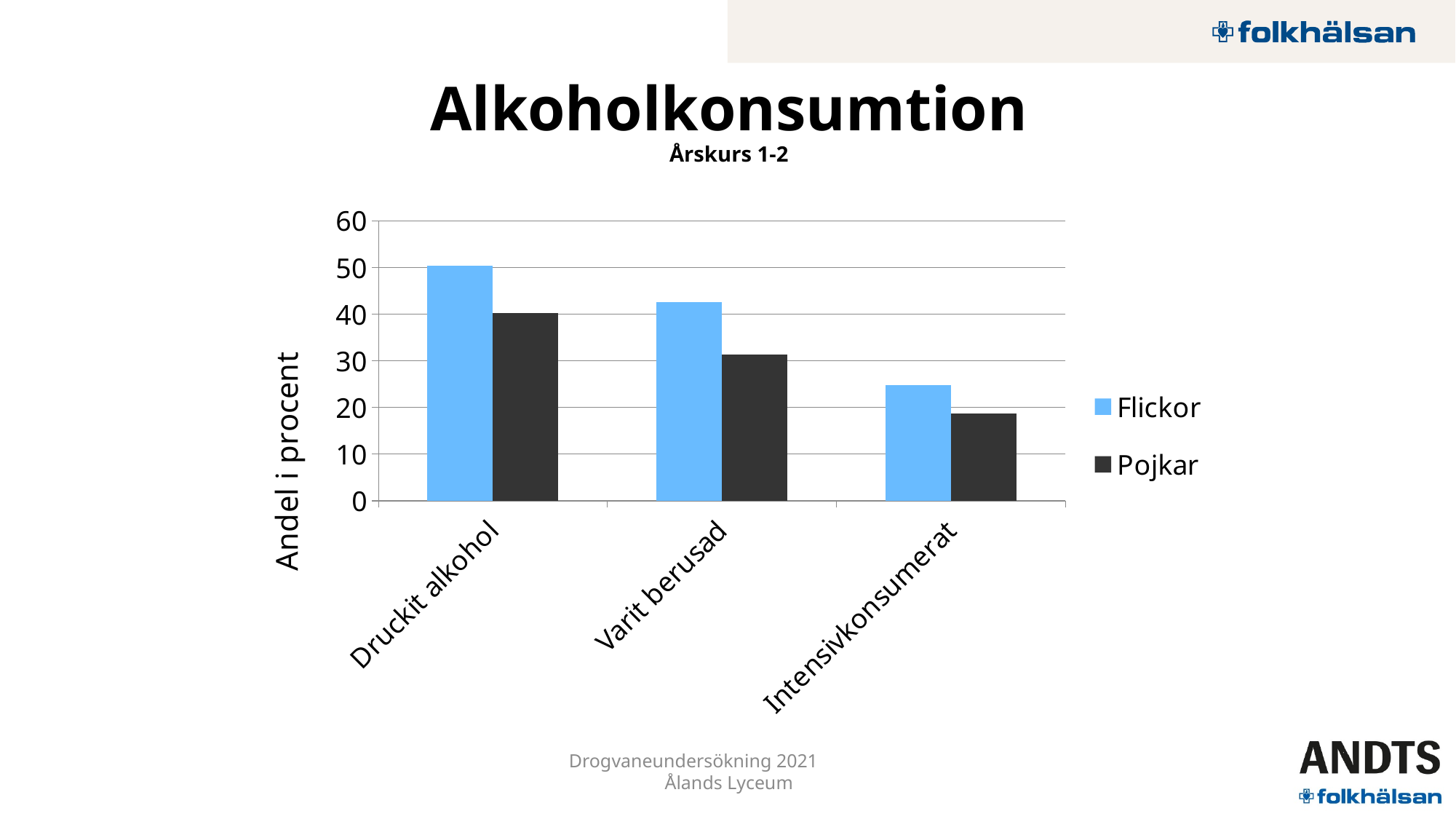
For Varit berusad, which series has the larger value, Flickor or Pojkar? Flickor How many categories are shown on the x axis? 3 Is the value for Pojkar in Intensivkonsumerat greater or less than 10? greater Is the value for Flickor in Intensivkonsumerat greater or less than 20? greater How many series does the legend list? 2 Do the Pojkar values rise or fall from Druckit alkohol to Intensivkonsumerat? fall What kind of chart is shown on the slide? bar chart Which category has the lowest value for Pojkar? Intensivkonsumerat Which category has the highest value for Flickor? Druckit alkohol What is the label on the vertical axis? Andel i procent Is the value for Flickor in Druckit alkohol greater or less than 40? greater